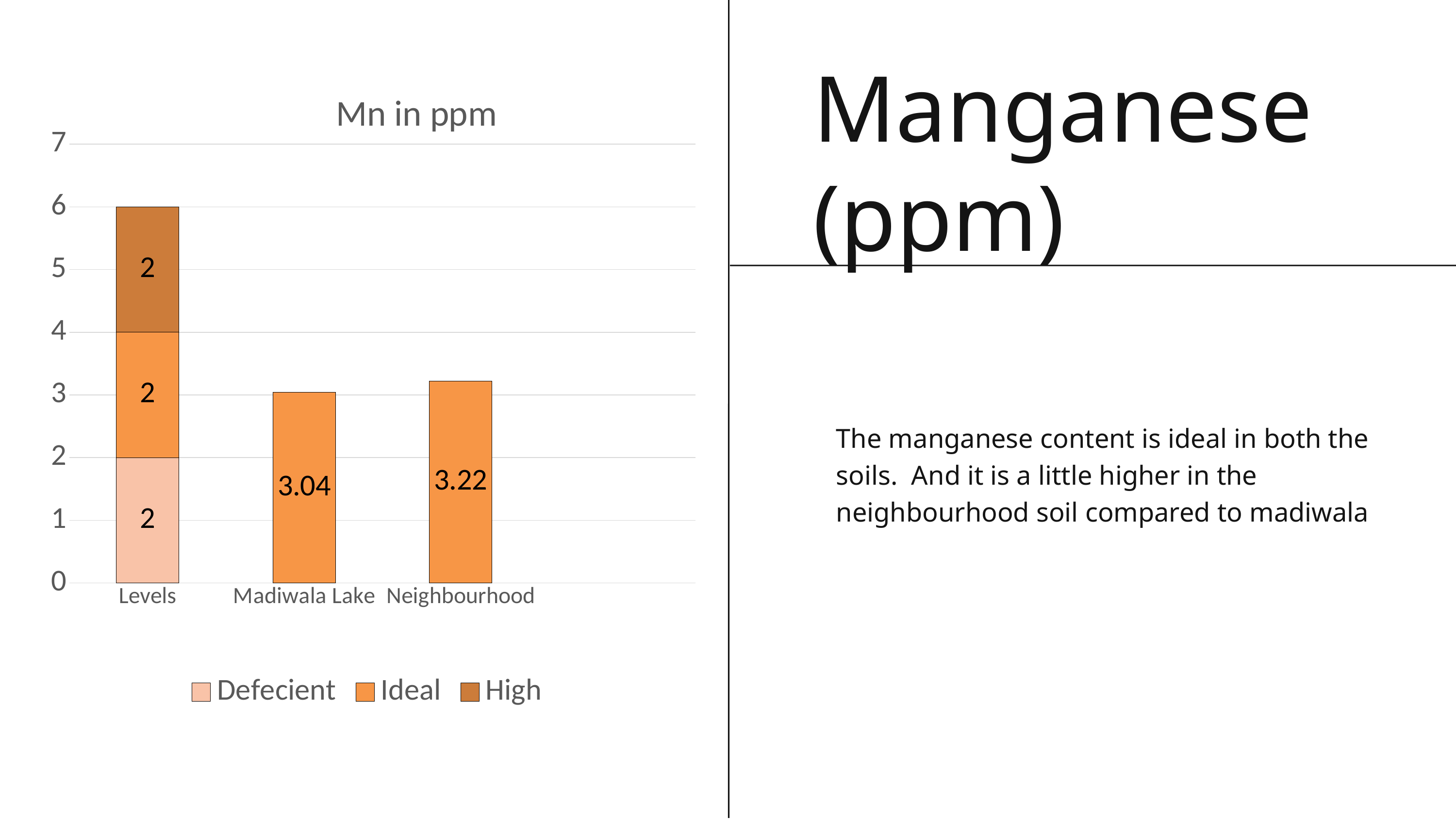
Is the value for Neighbourhood greater or less than 4? less What is the Defecient segment value in the Levels bar? 2 How many categories are shown on the x axis? 3 What type of chart is shown on the slide? bar chart What is the difference between the Neighbourhood and Madiwala Lake values? 0.18 Which is larger, the value for Madiwala Lake or the value for Neighbourhood? Neighbourhood What is the High segment value in the Levels bar? 2 What is the value for Neighbourhood? 3.22 What is the total of the stacked Levels bar? 6 What is the title of the chart? Mn in ppm What is the value for Madiwala Lake? 3.04 How many series does the legend list? 3